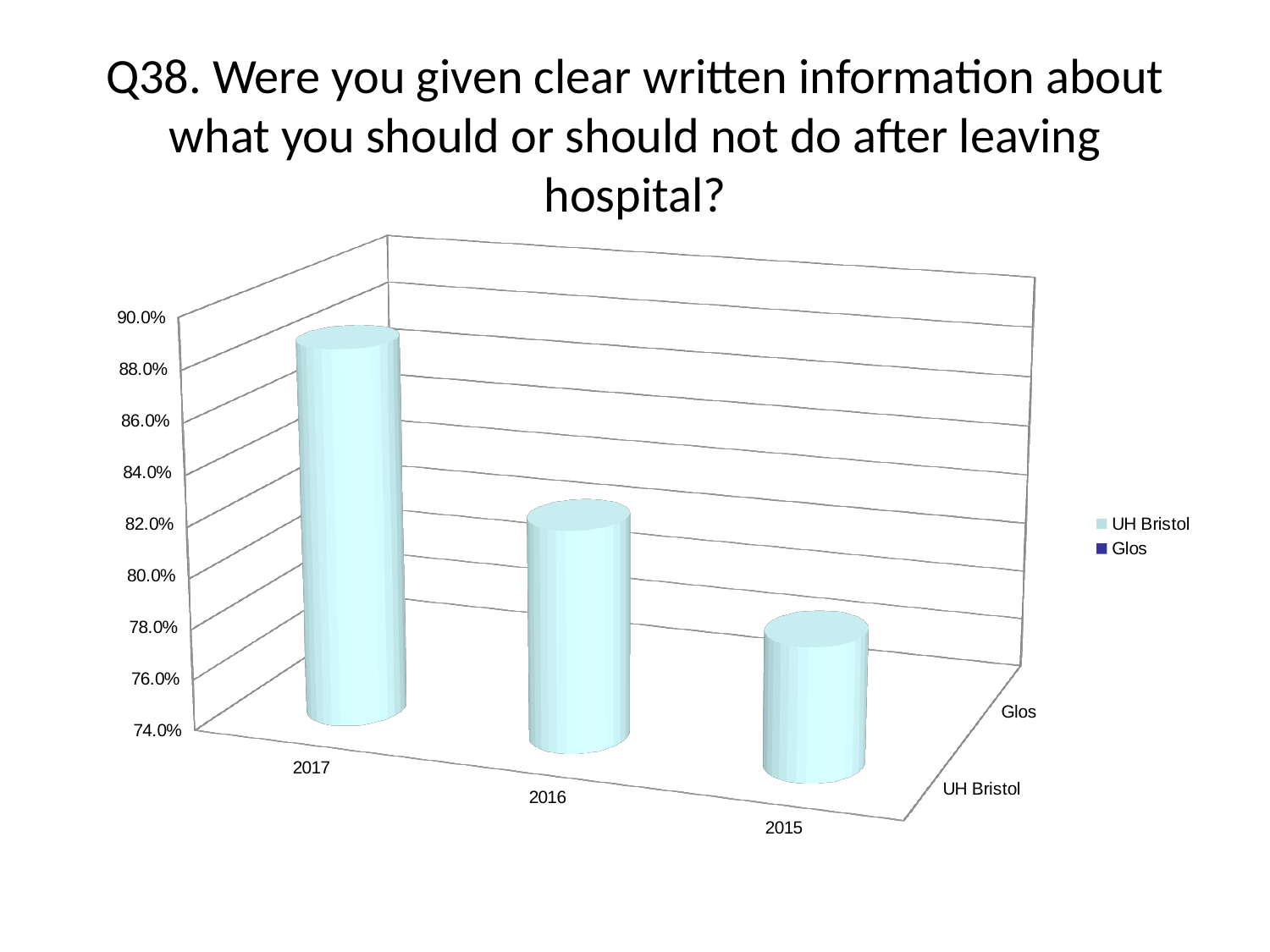
How many series does the legend list? 2 How many years are shown along the x axis? 3 What kind of chart is shown on the slide? bar chart Which year has the highest value for UH Bristol? 2017 Which is larger for UH Bristol, the value for 2016 or the value for 2017? 2017 What are the two series names listed in the legend? UH Bristol and Glos Which year has the lowest value for UH Bristol? 2015 Is the UH Bristol value for 2017 greater or less than 86.0%? greater Do the UH Bristol values rise or fall moving along the x axis from 2017 to 2015? fall Which is larger for UH Bristol, the value for 2017 or the value for 2015? 2017 Is the UH Bristol value for 2016 greater or less than 80.0%? greater